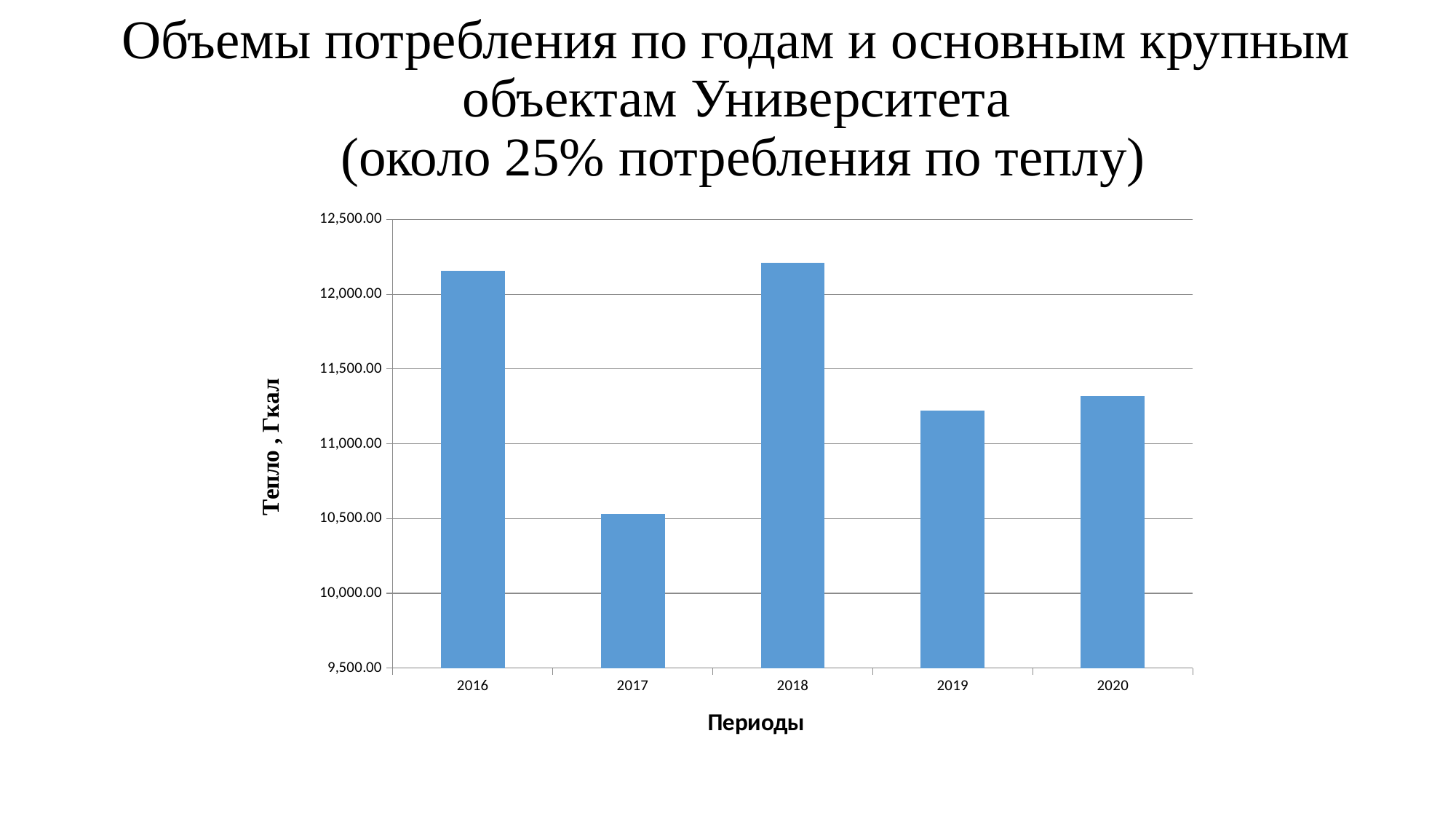
Which is larger, the value for 2017 or the value for 2019? 2019 What is the title of the vertical (y) axis of the chart? Тепло , Гкал Is the value for 2020 greater or less than 11,500.00? less Which year has the lowest heat consumption value in the chart? 2017 How many years (categories) are shown on the x axis of the chart? 5 Is the value for 2019 greater or less than 11,000.00? greater Is the value for 2017 greater or less than 11,000.00? less Which is larger, the value for 2016 or the value for 2020? 2016 What kind of chart is shown on the slide? bar chart From 2018 to 2019, does the value rise or fall? fall